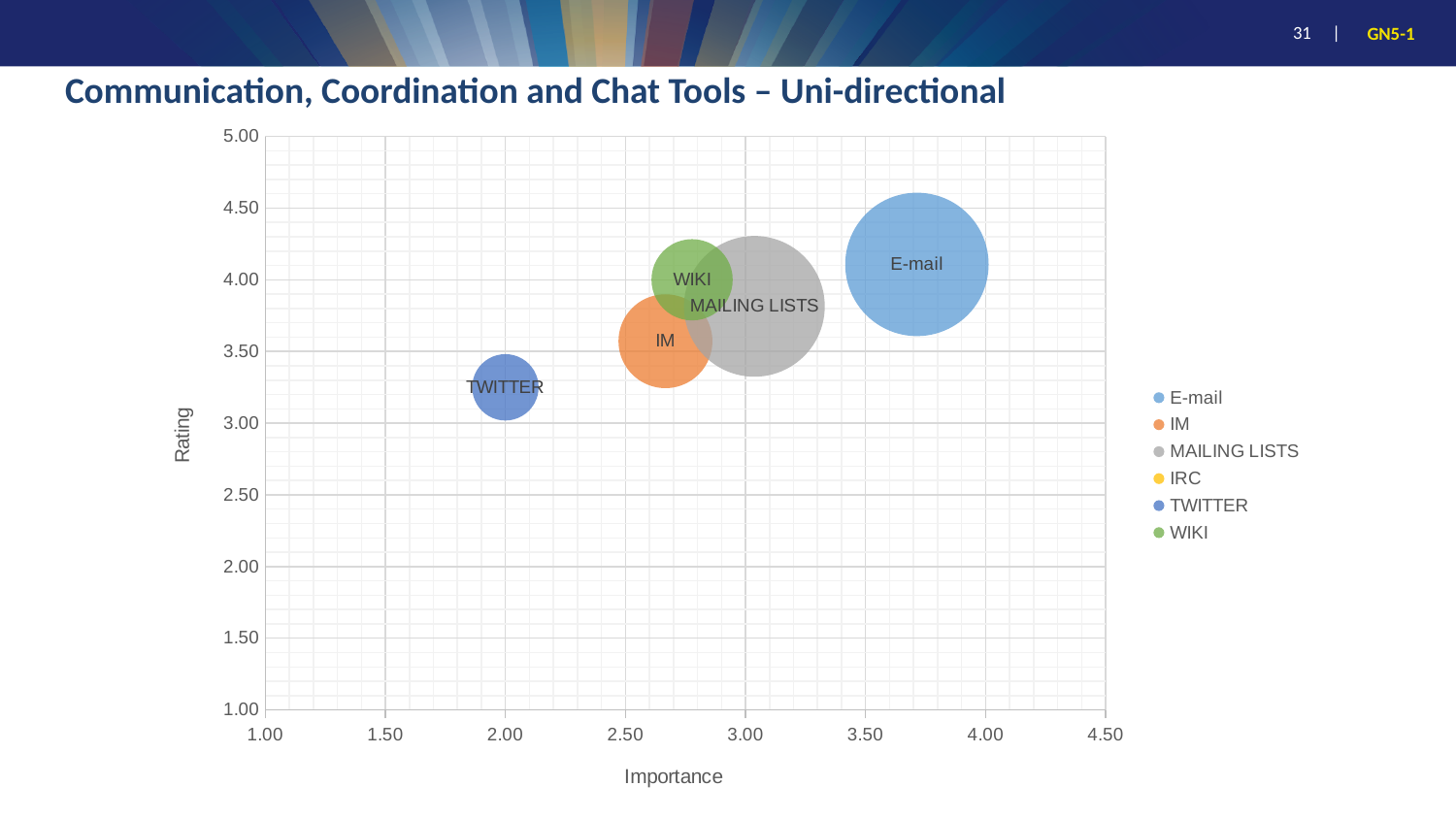
Is the Importance value for MAILING LISTS greater or less than 3.50? less Which tool has the lowest Rating? TWITTER Is the Importance value for E-mail greater or less than 3.50? greater How many bubbles are plotted on the chart? 5 How many series does the legend list? 6 Is the Rating value for TWITTER greater or less than 3.50? less Which tool has the lowest Importance? TWITTER Which has the higher Rating, IM or WIKI? WIKI Which tool has the highest Rating? E-mail What kind of chart is shown on the slide? Bubble chart What is the label of the vertical axis? Rating Which tool has the highest Importance? E-mail